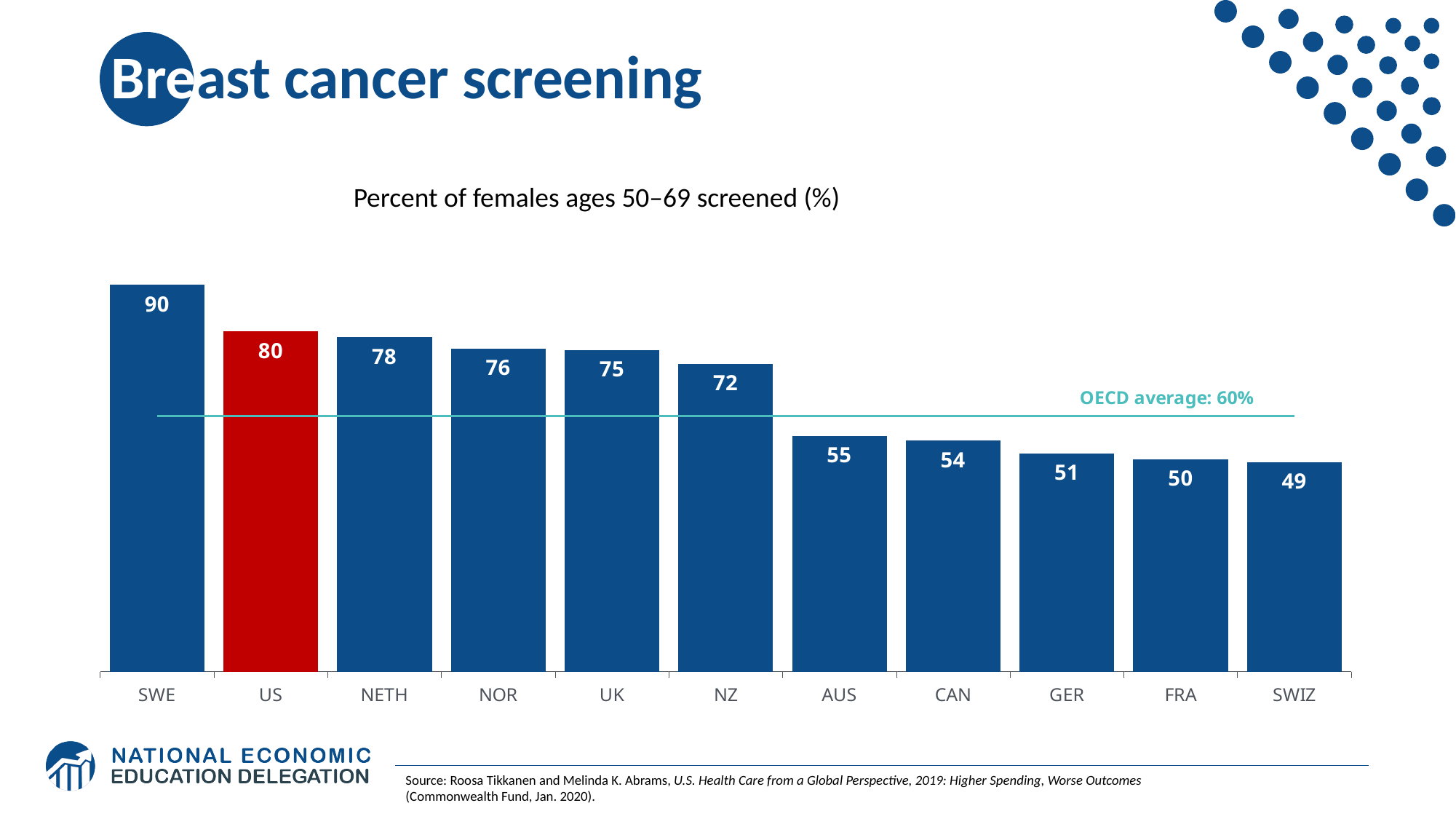
What kind of chart is this? bar chart Which country's bar is coloured red? US What is the value for the US? 80 What is the value for FRA? 50 What is the difference between the values for SWE and the US? 10 What is the value for NZ? 72 Which country has the highest value? SWE How many countries are shown on the chart? 11 Which country has the lowest value? SWIZ What is the difference between the values for NZ and AUS? 17 Which is larger, the value for NETH or the value for CAN? NETH What is the OECD average shown on the chart? 60%